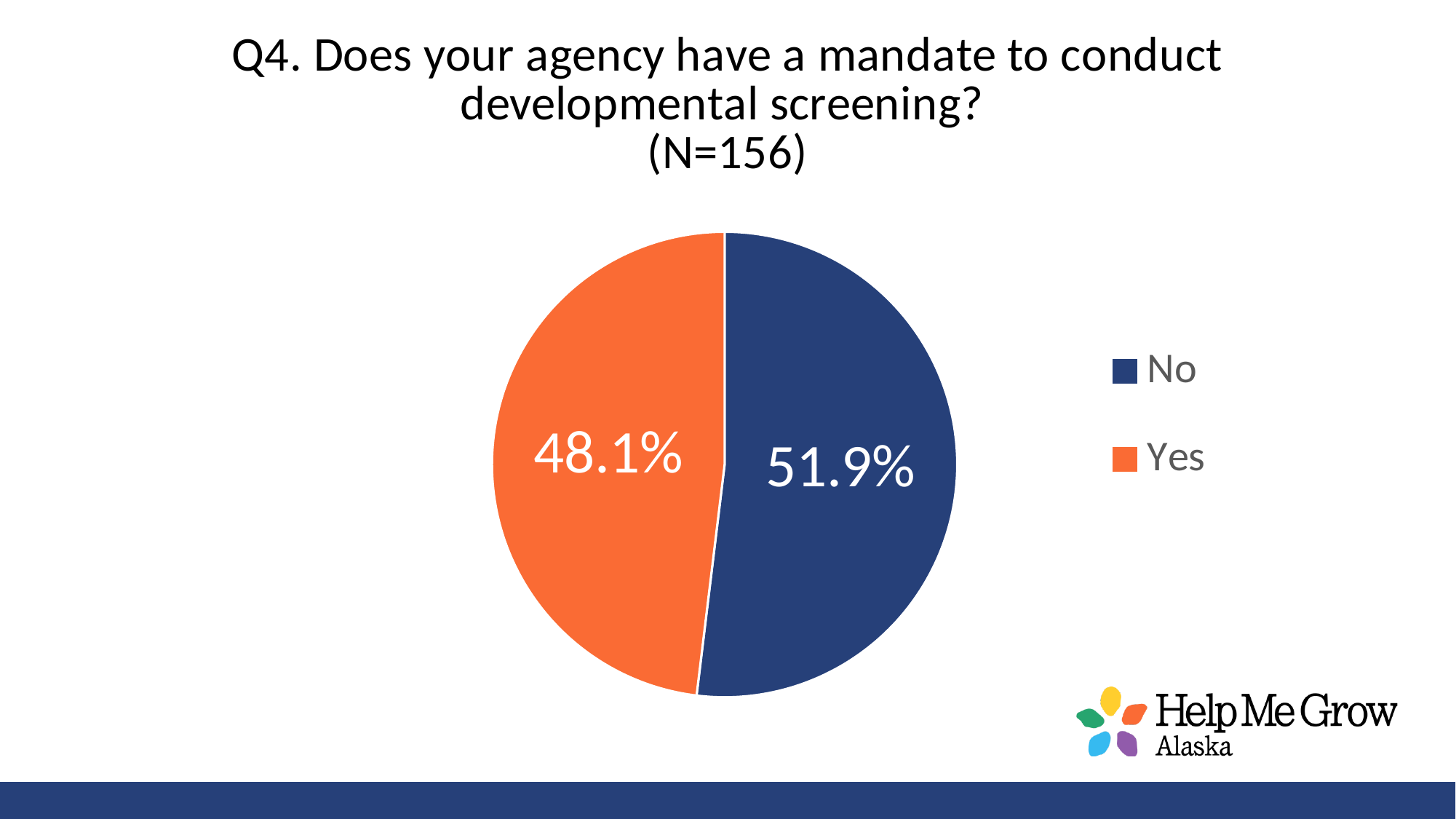
What percentage of respondents answered "Yes"? 48.1% What is the difference in percentage points between the "No" and "Yes" slices? 3.8 Is the value for "No" greater or less than 50%? greater Which response has the smaller share of the pie? Yes How many entries does the legend list? 2 What colour is the "Yes" slice? orange What is the sample size (N) stated in the chart title? 156 What kind of chart is shown on the slide? pie chart Is the share for "Yes" larger or smaller than the share for "No"? smaller How many slices does the pie chart have? 2 Which response has the larger share of the pie? No What percentage of respondents answered "No"? 51.9%